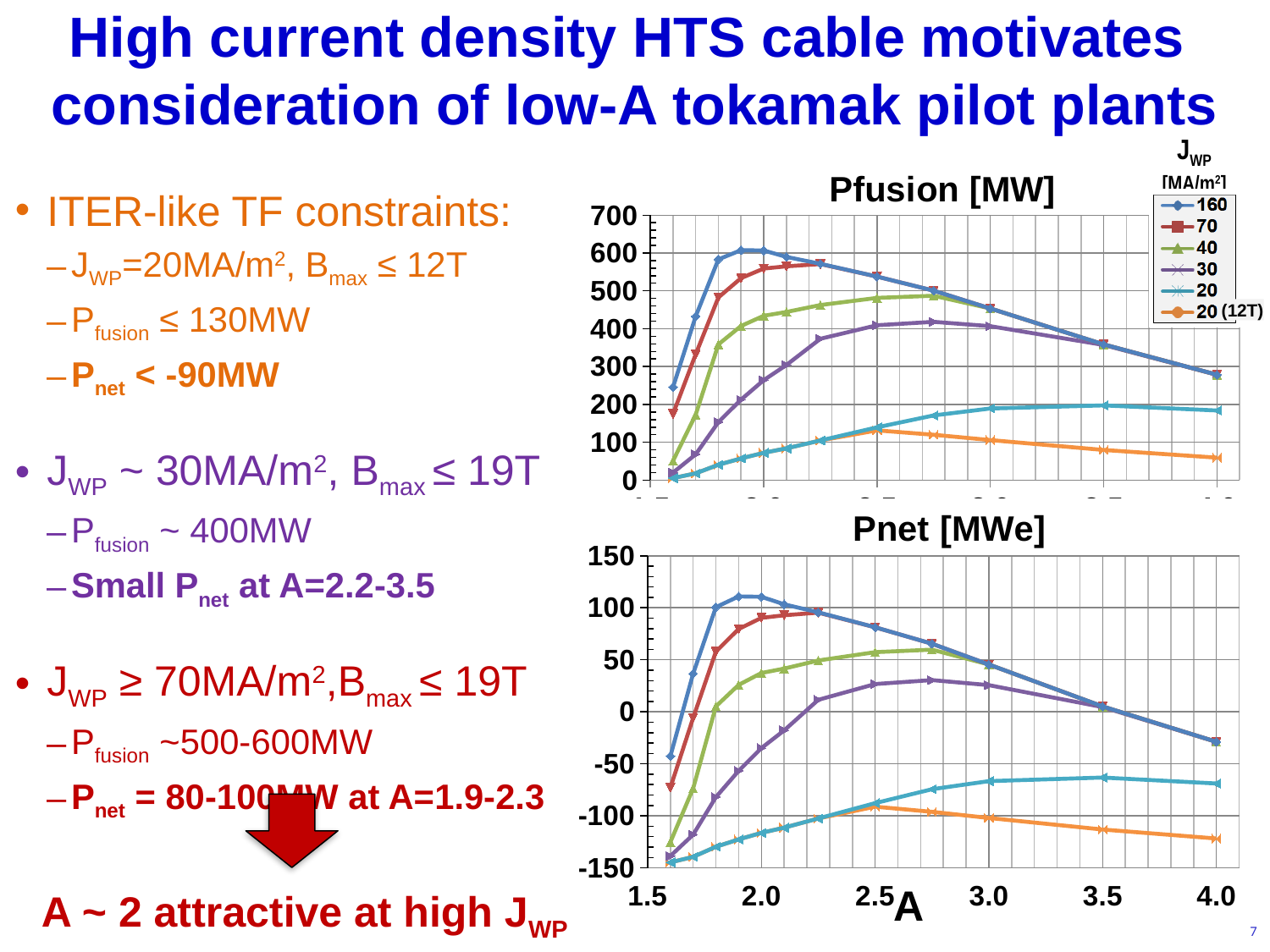
In the Pnet [MWe] chart, is the value of the 20 (12T) series at A=4.0 greater or less than -100? less What is the title of the lower chart on the slide? Pnet [MWe] In the Pfusion [MW] chart, is the peak value of the 20 (12T) series greater or less than 200? less In the Pfusion [MW] chart, which JWP series has the lowest value at A=4.0? 20 (12T) In the Pfusion [MW] chart, is the peak value of the 160 series greater or less than 500? greater In the Pnet [MWe] chart, does the 20 series rise or fall between A=1.5 and A=3.5? rise In the Pfusion [MW] chart, which JWP series reaches the highest peak value? 160 How many series does the legend list for the charts? 6 In the Pnet [MWe] chart, which series has the larger peak value, 70 or 40? 70 In the Pnet [MWe] chart, which JWP series reaches the highest peak value? 160 What kind of chart is the Pfusion [MW] chart? line chart